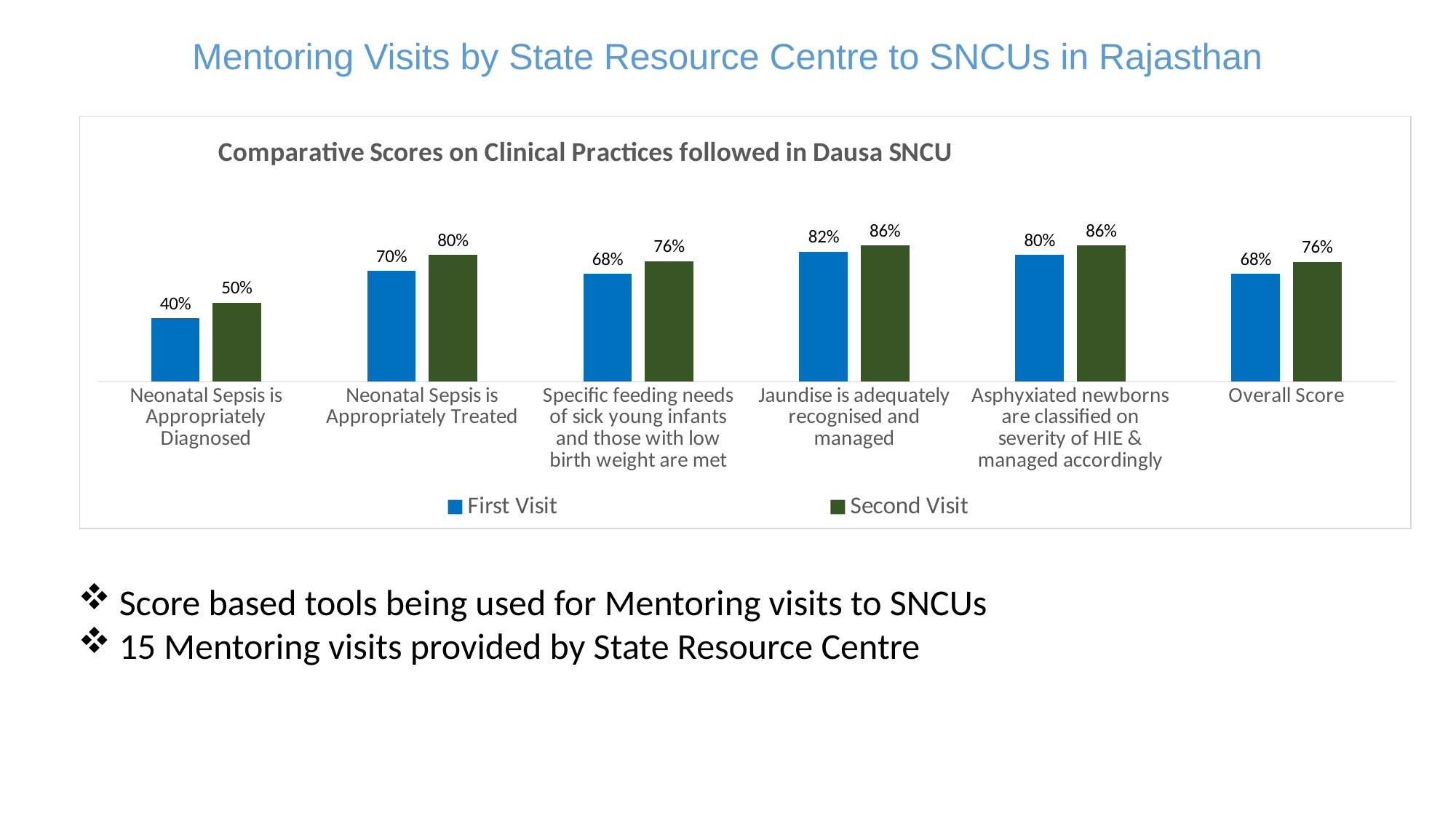
How many categories are shown on the x axis? 6 How many series does the legend list? 2 What is the Second Visit score for 'Overall Score'? 76% What is the Second Visit score for 'Jaundise is adequately recognised and managed'? 86% Which category has the highest First Visit score? Jaundise is adequately recognised and managed What is the title of the chart? Comparative Scores on Clinical Practices followed in Dausa SNCU What is the difference between the Second Visit and First Visit scores for 'Neonatal Sepsis is Appropriately Treated'? 10% What kind of chart is shown on the slide? Bar chart Which is larger: the First Visit score for 'Asphyxiated newborns are classified on severity of HIE & managed accordingly' or the First Visit score for 'Overall Score'? Asphyxiated newborns are classified on severity of HIE & managed accordingly What is the difference between the Second Visit and First Visit scores for 'Overall Score'? 8% Which category has the lowest First Visit score? Neonatal Sepsis is Appropriately Diagnosed What is the First Visit score for 'Neonatal Sepsis is Appropriately Diagnosed'? 40%